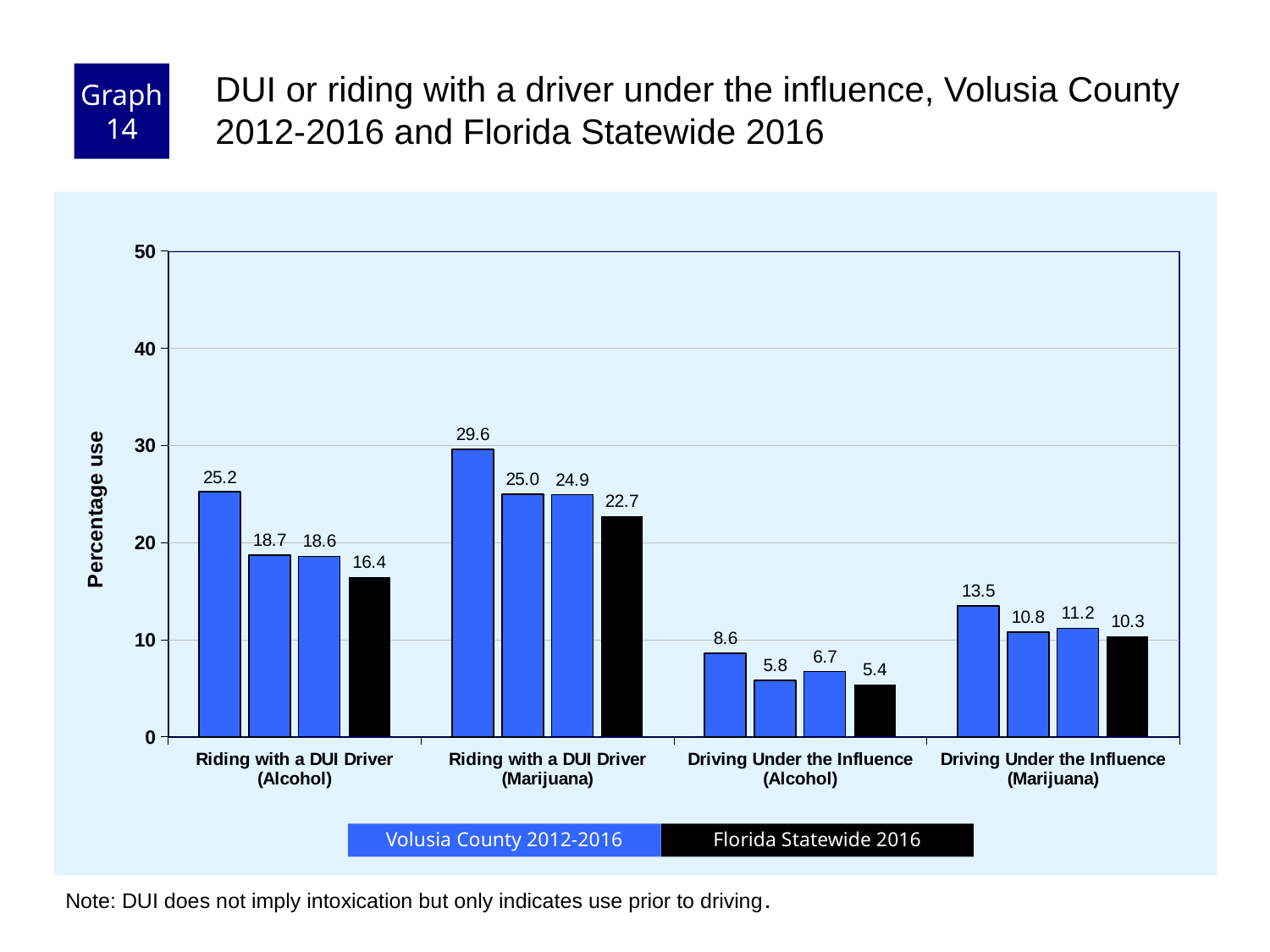
What is the Florida Statewide 2016 value for Riding with a DUI Driver (Alcohol)? 16.4 What is the value of the first Volusia County 2012-2016 bar for Riding with a DUI Driver (Marijuana)? 29.6 Which is larger: the Florida Statewide 2016 value for Riding with a DUI Driver (Alcohol) or for Driving Under the Influence (Marijuana)? Riding with a DUI Driver (Alcohol) Is the Florida Statewide 2016 value for Riding with a DUI Driver (Marijuana) greater or less than 20? greater How many categories are shown on the x axis? 4 Which category has the lowest bar on the chart? Driving Under the Influence (Alcohol) What is the Florida Statewide 2016 value for Driving Under the Influence (Alcohol)? 5.4 Which category has the highest bar on the chart? Riding with a DUI Driver (Marijuana) What is the Florida Statewide 2016 value for Driving Under the Influence (Marijuana)? 10.3 How many series does the legend list? 2 What kind of chart is shown on the slide? bar chart What is the difference between the Florida Statewide 2016 values for Riding with a DUI Driver (Marijuana) and Riding with a DUI Driver (Alcohol)? 6.3